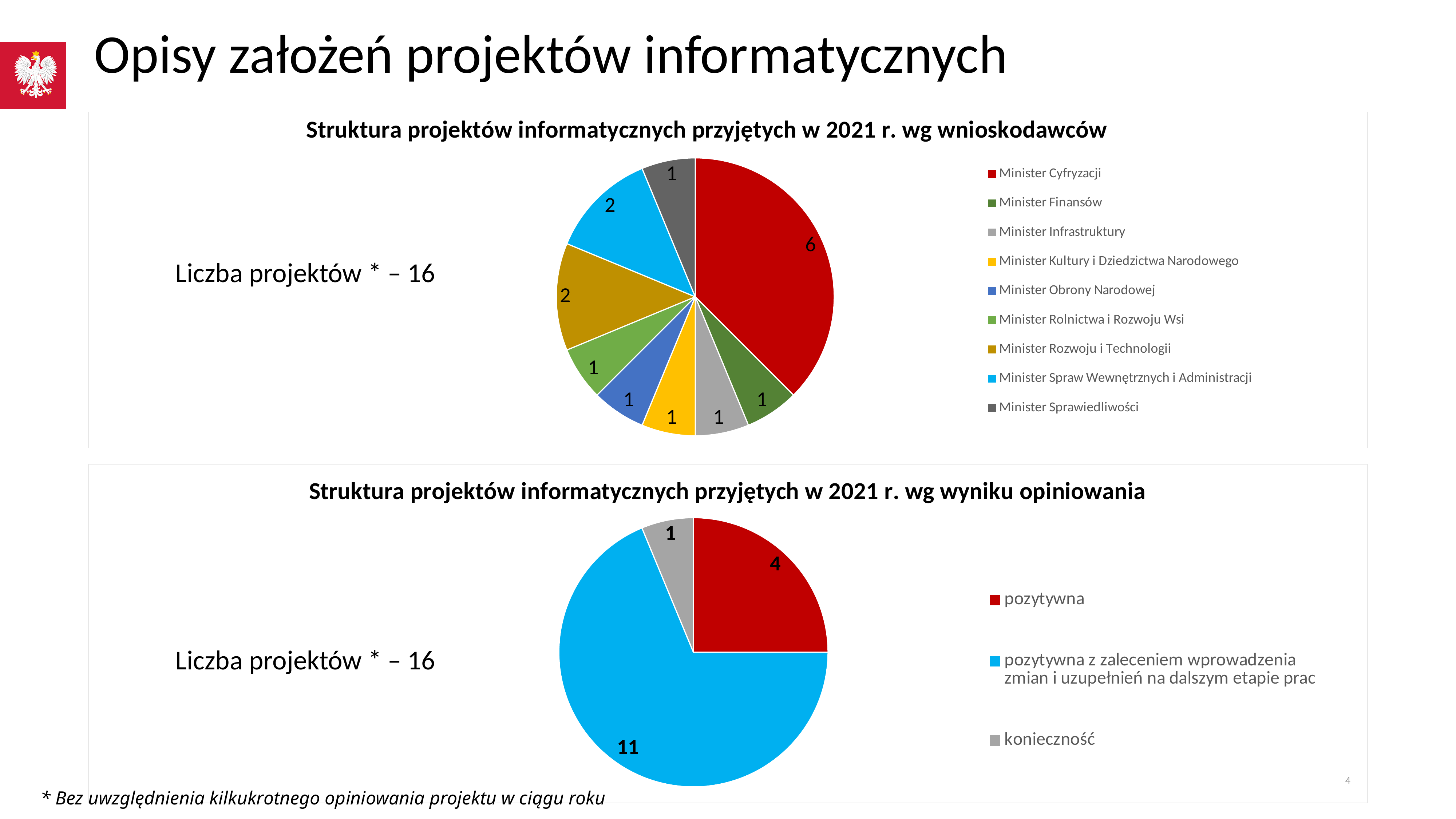
In the top chart (wg wnioskodawców), which is larger: the value for Minister Rozwoju i Technologii or the value for Minister Sprawiedliwości? Minister Rozwoju i Technologii In the bottom chart (wg wyniku opiniowania), what is the difference between the 'pozytywna z zaleceniem wprowadzenia zmian i uzupełnień na dalszym etapie prac' slice and the 'pozytywna' slice? 7 In the top chart (wg wnioskodawców), how many applicant categories does the legend list? 9 In the top chart (wg wnioskodawców), how many projects are attributed to Minister Rozwoju i Technologii? 2 In the top chart (wg wnioskodawców), how many projects are attributed to Minister Cyfryzacji? 6 In the top chart (Struktura projektów informatycznych przyjętych w 2021 r. wg wnioskodawców), what kind of chart is shown? Pie chart In the bottom chart (wg wyniku opiniowania), what colour is the slice for 'konieczność'? Grey In the bottom chart (wg wyniku opiniowania), which opinion category has the smallest slice? konieczność In the top chart (wg wnioskodawców), what is the difference between the number of projects for Minister Cyfryzacji and Minister Spraw Wewnętrznych i Administracji? 4 In the bottom chart (Struktura projektów informatycznych przyjętych w 2021 r. wg wyniku opiniowania), how many projects received the opinion 'pozytywna'? 4 In the top chart (wg wnioskodawców), which applicant has the largest slice? Minister Cyfryzacji In the bottom chart (wg wyniku opiniowania), what share of the pie does the 'pozytywna' slice represent? 25%